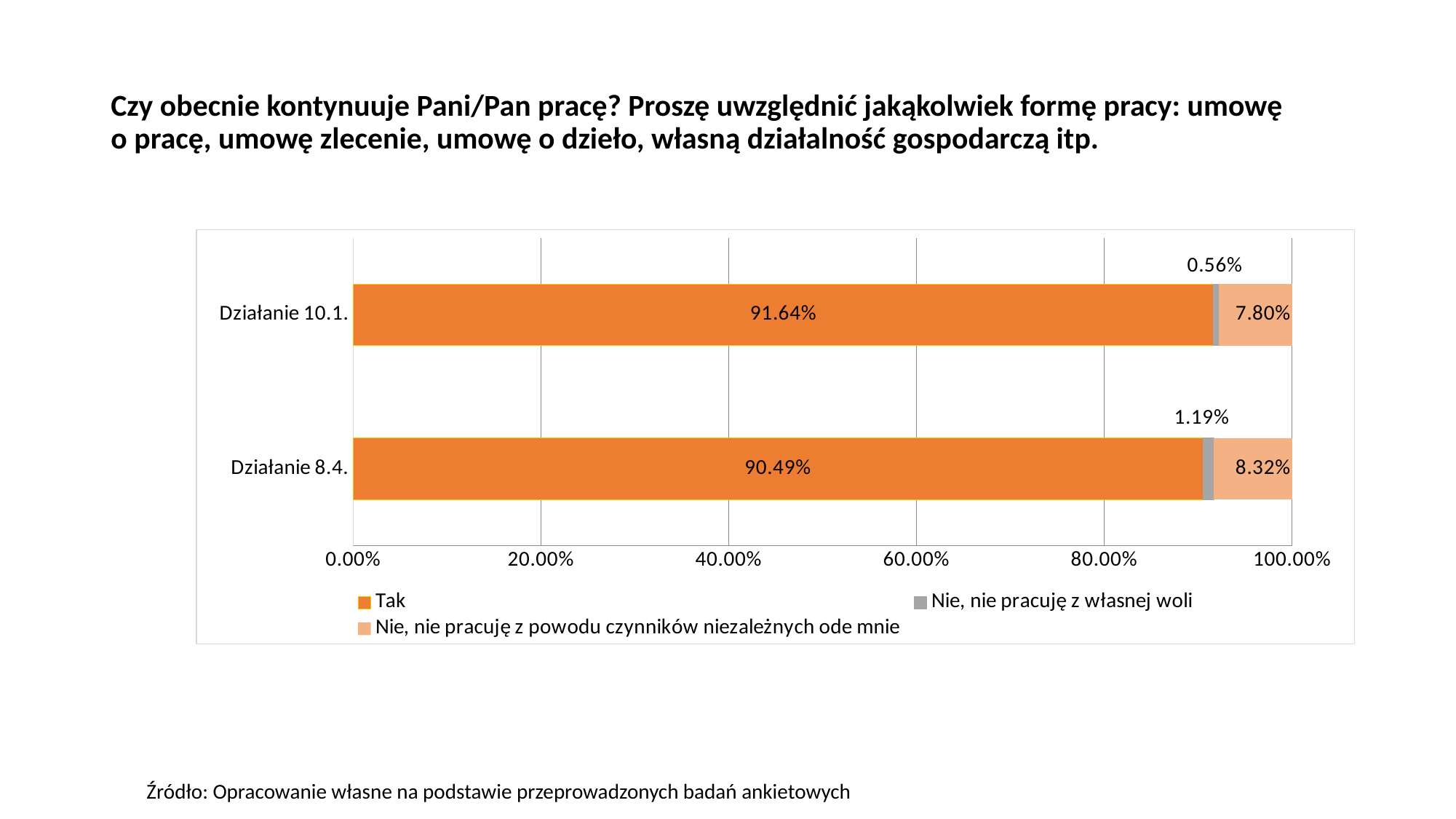
What is the value of "Nie, nie pracuję z własnej woli" for Działanie 8.4.? 1.19% What is the value of "Tak" for Działanie 10.1.? 91.64% What is the value of "Tak" for Działanie 8.4.? 90.49% What is the value of "Nie, nie pracuję z powodu czynników niezależnych ode mnie" for Działanie 8.4.? 8.32% What is the difference between the "Tak" values for Działanie 10.1. and Działanie 8.4.? 1.15% How many categories are shown on the chart? 2 Which category has the higher value for "Tak"? Działanie 10.1. Is the value of "Tak" for Działanie 8.4. greater or less than 80.00%? greater How many series does the legend list? 3 Which is larger: "Nie, nie pracuję z powodu czynników niezależnych ode mnie" for Działanie 8.4. or for Działanie 10.1.? Działanie 8.4. What is the value of "Nie, nie pracuję z własnej woli" for Działanie 10.1.? 0.56% What kind of chart is shown on the slide? Stacked bar chart